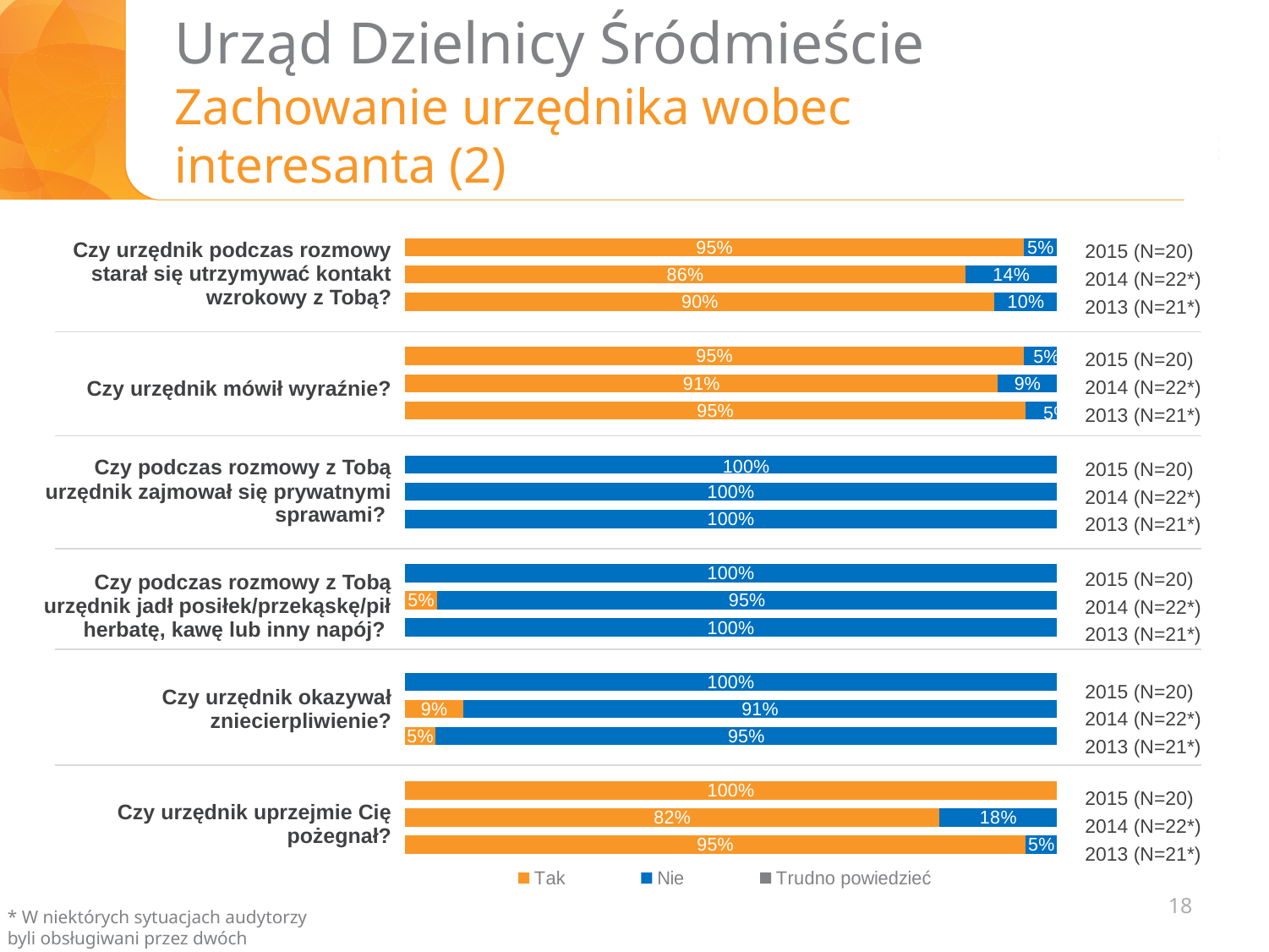
What percentage answered "Nie" in 2014 for "Czy urzędnik uprzejmie Cię pożegnał?"? 18% For "Czy urzędnik uprzejmie Cię pożegnał?", which year had the highest "Tak" share? 2015 For "Czy urzędnik podczas rozmowy starał się utrzymywać kontakt wzrokowy z Tobą?", what is the difference in the "Tak" share between 2015 and 2014? 9 percentage points What percentage answered "Nie" in 2014 for "Czy urzędnik mówił wyraźnie?"? 9% What percentage answered "Tak" in 2014 for "Czy urzędnik podczas rozmowy starał się utrzymywać kontakt wzrokowy z Tobą?"? 86% How many series does the legend list? 3 What kind of chart is shown on the slide? Stacked bar chart What are the legend entries of the chart? Tak, Nie, Trudno powiedzieć What percentage answered "Tak" in 2014 for "Czy podczas rozmowy z Tobą urzędnik jadł posiłek/przekąskę/pił herbatę, kawę lub inny napój?"? 5% What percentage answered "Tak" in 2013 for "Czy urzędnik mówił wyraźnie?"? 95% How many survey questions are shown in the chart? 6 For "Czy urzędnik okazywał zniecierpliwienie?", which year had the larger "Tak" share, 2014 or 2013? 2014